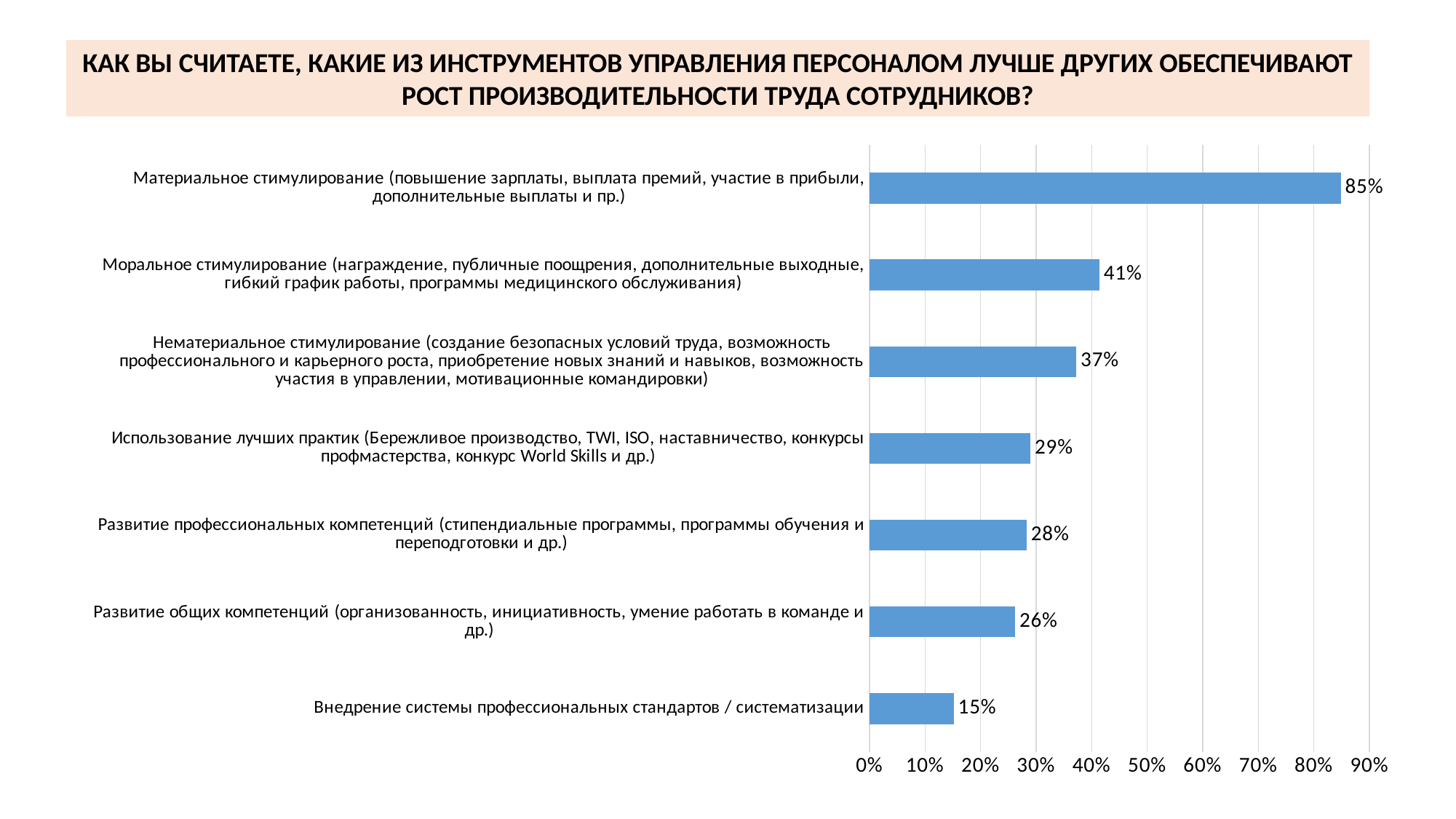
What is the value for Использование лучших практик? 29% What is the difference between the values for Нематериальное стимулирование and Развитие общих компетенций? 11% Which category has the lowest value? Внедрение системы профессиональных стандартов / систематизации Is the value for Развитие профессиональных компетенций greater or less than 30%? less What kind of chart is shown on the slide? bar chart What is the value for Моральное стимулирование? 41% What is the value for Материальное стимулирование? 85% How many categories are shown in the chart? 7 Which is larger: the value for Нематериальное стимулирование or the value for Использование лучших практик? Нематериальное стимулирование Which category has the highest value? Материальное стимулирование What is the difference between the values for Материальное стимулирование and Моральное стимулирование? 44% What is the value for Внедрение системы профессиональных стандартов / систематизации? 15%